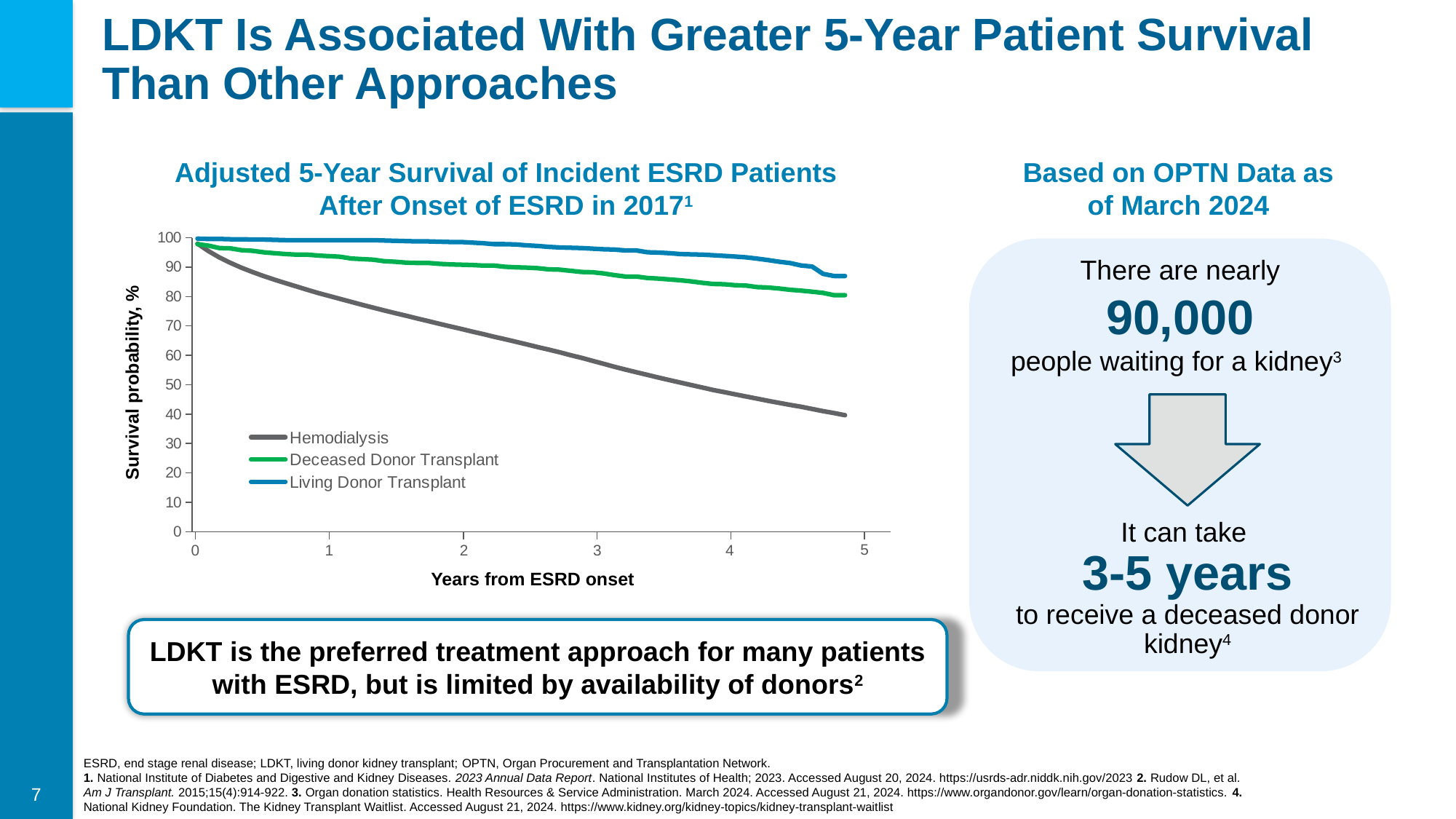
Is the survival probability for Deceased Donor Transplant at 5 years greater or less than 70? greater How many series does the chart legend list? 3 Is the survival probability for Living Donor Transplant at 5 years greater or less than 80? greater At 2 years from ESRD onset, which has the higher survival probability: Hemodialysis or Deceased Donor Transplant? Deceased Donor Transplant What kind of chart is shown on the slide? Line chart Which series has the lowest survival probability at 5 years from ESRD onset? Hemodialysis Does the survival probability for Hemodialysis rise or fall as years from ESRD onset increase? Fall What is the label of the x axis of the chart? Years from ESRD onset Is the survival probability for Hemodialysis at 5 years greater or less than 50? less What is the label of the y axis of the chart? Survival probability, % Which series has the highest survival probability at 5 years from ESRD onset? Living Donor Transplant